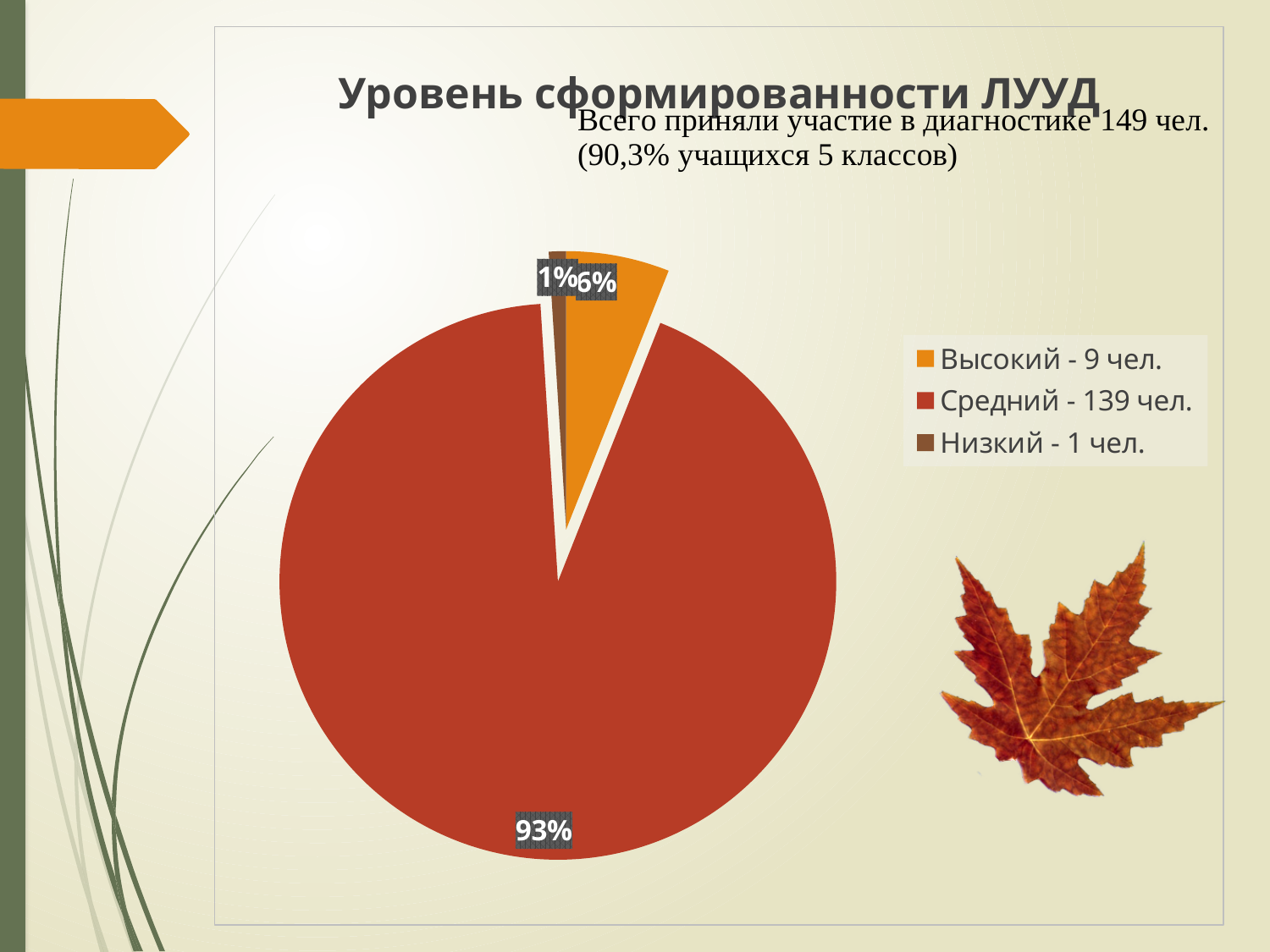
Which category has the smallest slice of the pie? Низкий - 1 чел. What colour is the "Средний - 139 чел." slice? red How many slices does the pie chart have? 3 What kind of chart is shown on the slide? pie chart What percentage share does the "Средний - 139 чел." slice have? 93% What is the title of the chart? Уровень сформированности ЛУУД What percentage share does the "Высокий - 9 чел." slice have? 6% How many entries does the legend list? 3 Which category has the largest slice of the pie? Средний - 139 чел. What percentage share does the "Низкий - 1 чел." slice have? 1% What is the difference in percentage points between the "Средний" slice and the "Высокий" slice? 87 Which slice is larger, "Высокий - 9 чел." or "Низкий - 1 чел."? Высокий - 9 чел.